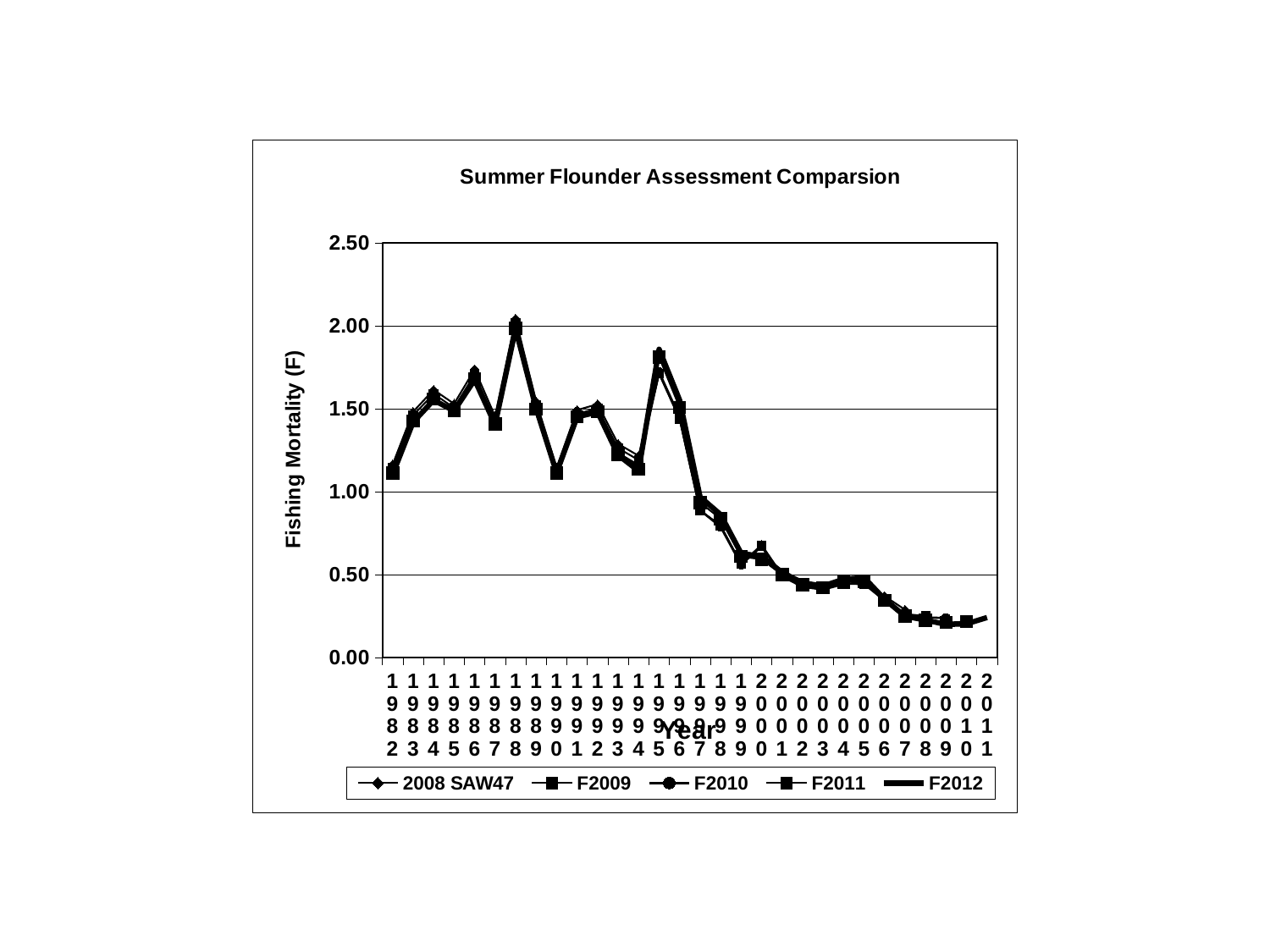
How many years are plotted along the x axis? 30 Is the value for 2000 greater or less than 0.50? greater How many series does the legend list? 5 Do the fishing mortality values generally rise or fall from 1998 to 2011? fall What kind of chart is shown on the slide? line chart Which year has the larger fishing mortality, 1995 or 1990? 1995 Is the value for 1982 greater or less than 1.00? greater In which year do the series reach their highest fishing mortality? 1988 What is the title of the chart? Summer Flounder Assessment Comparsion What is the label of the y axis? Fishing Mortality (F) Is the value for 1998 greater or less than 1.50? less